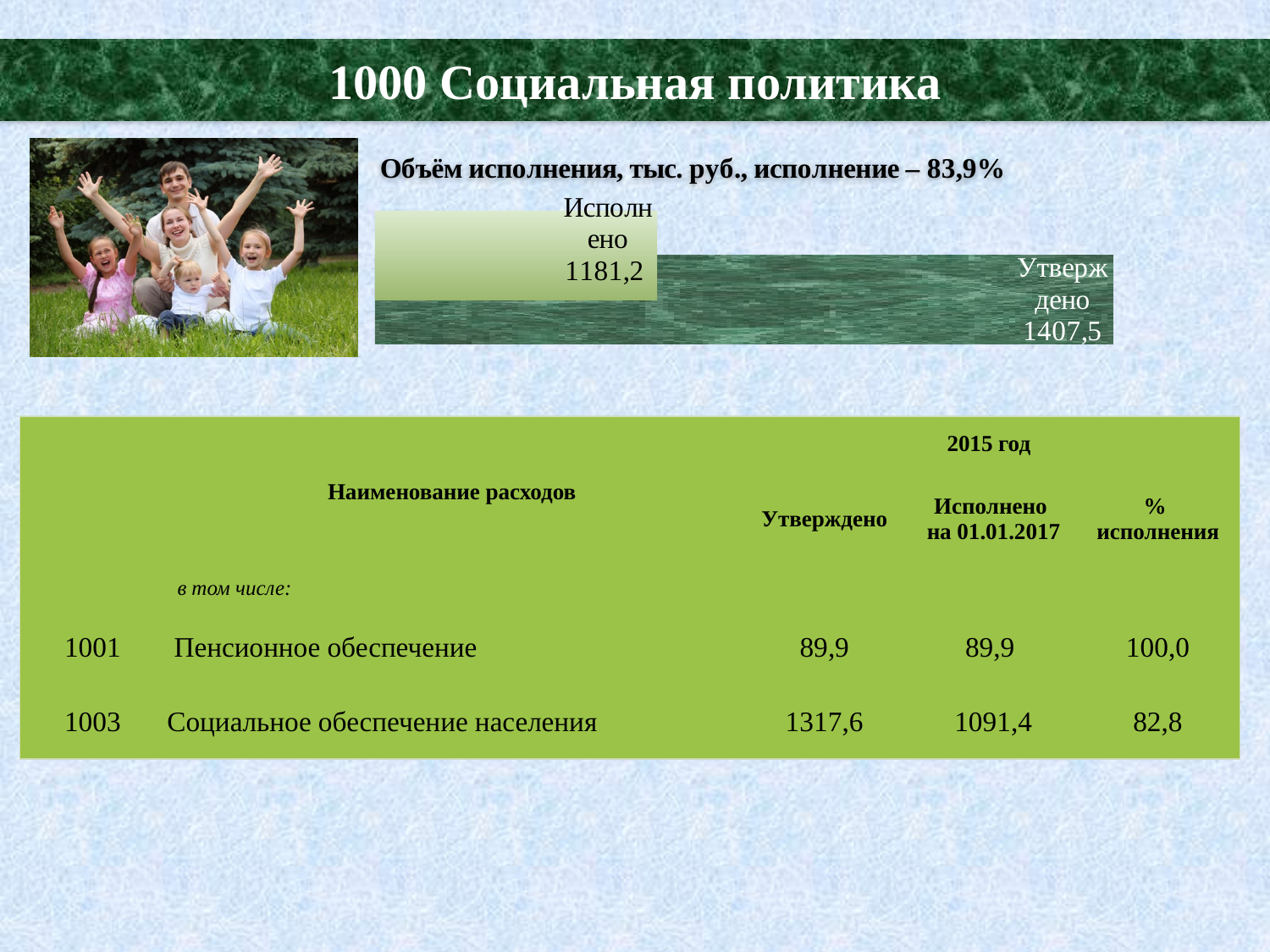
What execution percentage is stated in the chart title? 83,9% Which category in the chart has the lowest value? Исполнено What is the value of the "Исполнено" bar in the chart? 1181,2 What is the title of the chart? Объём исполнения, тыс. руб., исполнение – 83,9% How many bars are shown in the chart? 2 What kind of chart is shown on the slide? bar chart What is the difference between the "Утверждено" and "Исполнено" values in the chart? 226,3 What is the value of the "Утверждено" bar in the chart? 1407,5 Which bar in the chart has the higher value, "Исполнено" or "Утверждено"? Утверждено Which category in the chart has the highest value? Утверждено